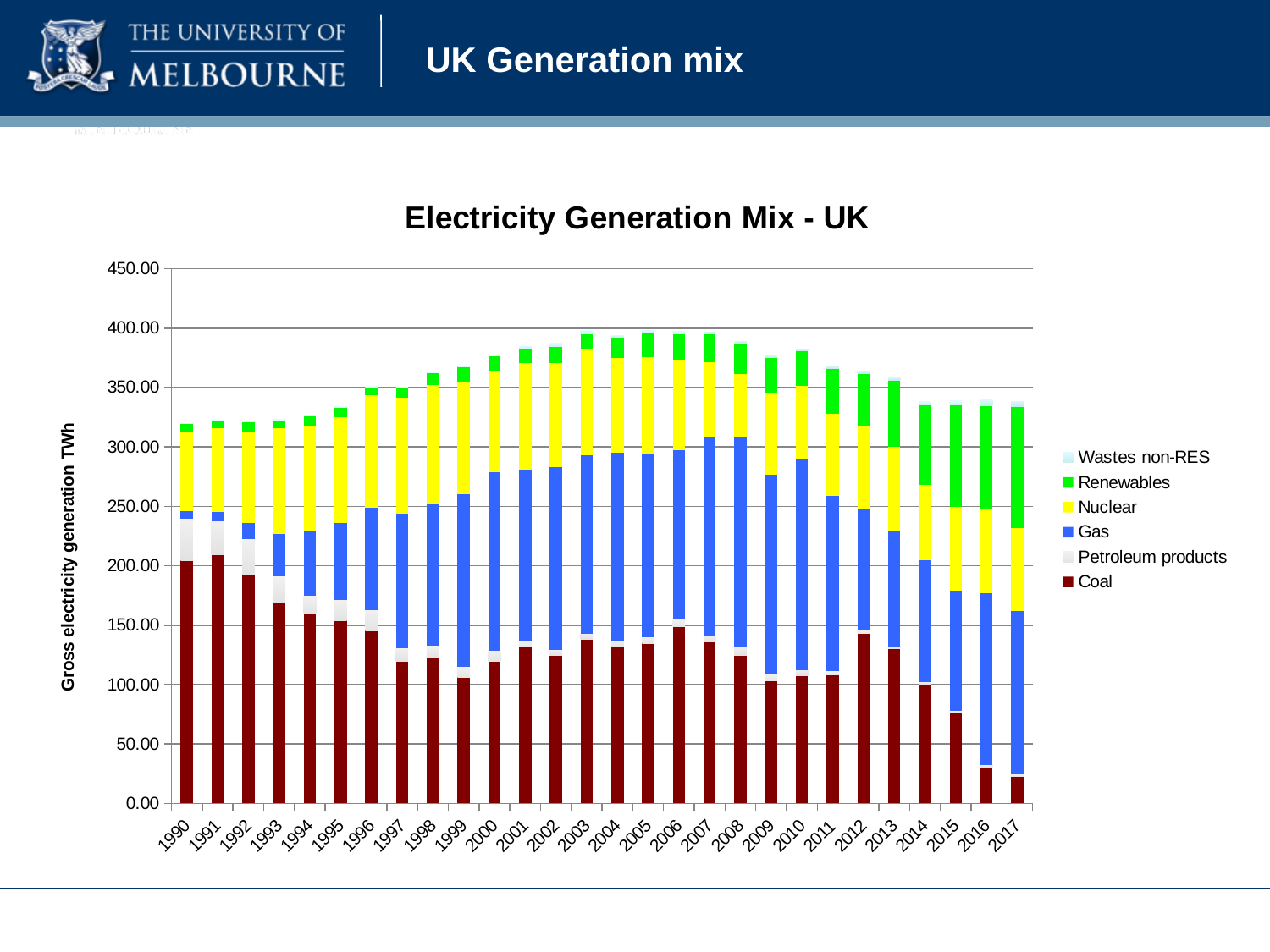
How many series does the legend list? 6 What kind of chart is shown on the slide? Stacked bar chart Is the value for Coal in 1991 greater or less than 200? greater What is the label on the y axis? Gross electricity generation TWh Is the value for Coal in 2017 greater or less than 50? less Is the total stacked bar for 2005 greater or less than 350? greater Which year has the lowest value for Coal? 2017 How many years are shown along the x axis? 28 Does the Coal value rise or fall from 2013 to 2017? Fall What is the title of the chart? Electricity Generation Mix - UK